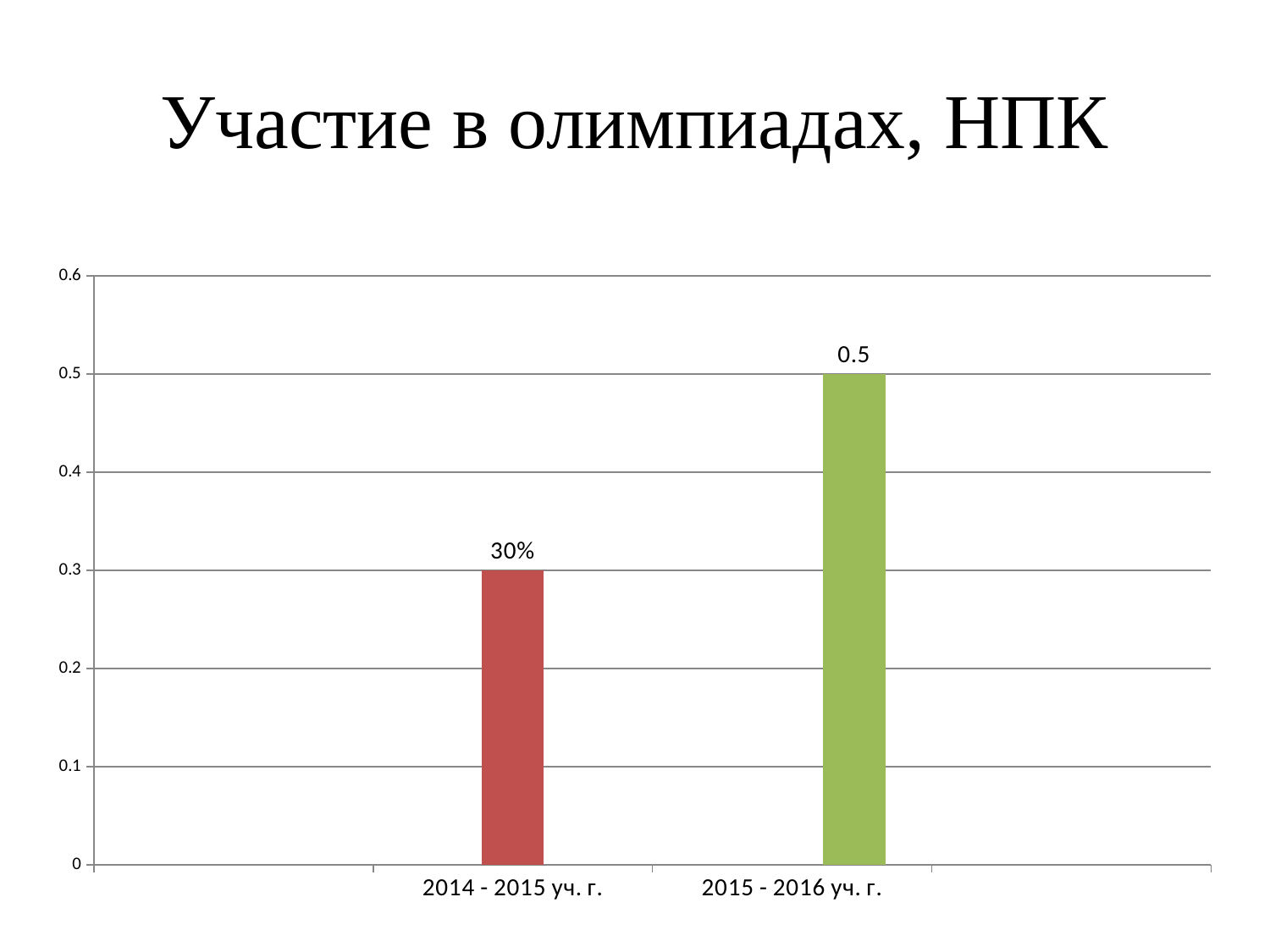
Which category has the highest value? 2015 - 2016 уч. г. What colour is the bar for 2015 - 2016 уч. г.? green What kind of chart is shown on the slide? bar chart Is the value for 2014 - 2015 уч. г. greater or less than 0.4? less Which category has the lowest value? 2014 - 2015 уч. г. What is the value for 2015 - 2016 уч. г.? 0.5 What is the value for 2014 - 2015 уч. г.? 30% Do the values rise or fall from 2014 - 2015 уч. г. to 2015 - 2016 уч. г.? rise How many categories are shown on the x axis? 2 Is the value for 2015 - 2016 уч. г. greater or less than 0.4? greater Which is larger, the value for 2014 - 2015 уч. г. or the value for 2015 - 2016 уч. г.? 2015 - 2016 уч. г. What is the title of the slide? Участие в олимпиадах, НПК